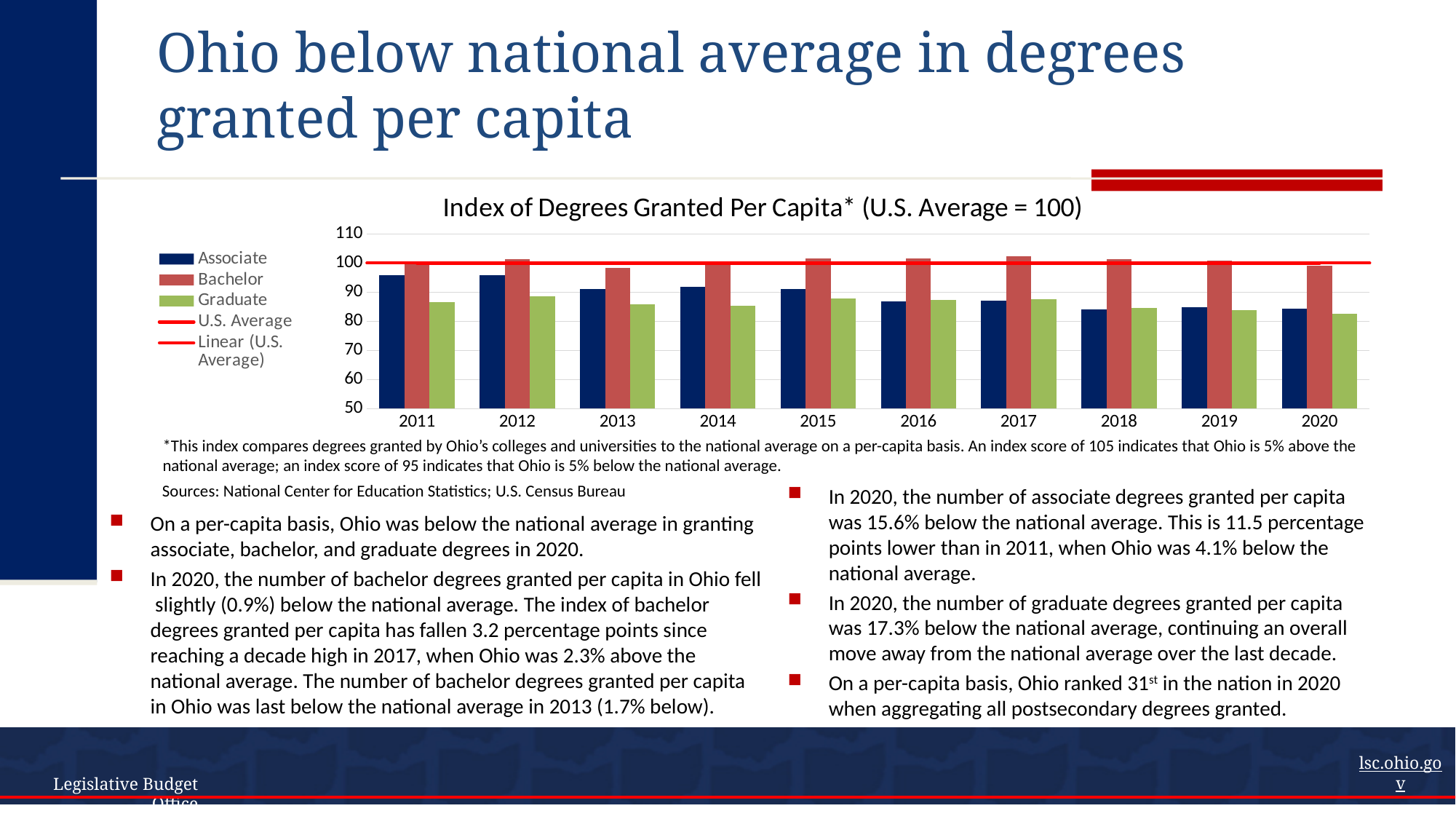
Is the Bachelor value for 2013 greater or less than 100? less Do the Associate values generally rise or fall from 2011 to 2020? fall Which series has the larger value in 2011, Bachelor or Graduate? Bachelor Is the Graduate value for 2020 greater or less than 90? less How many entries does the chart's legend list? 5 Is the Graduate value for 2011 greater or less than 90? less What kind of chart is shown on the slide? combination bar and line chart How many years are shown on the x axis of the chart? 10 Which is larger, the Associate value for 2011 or the Associate value for 2020? 2011 What is the title of the chart? Index of Degrees Granted Per Capita* (U.S. Average = 100)